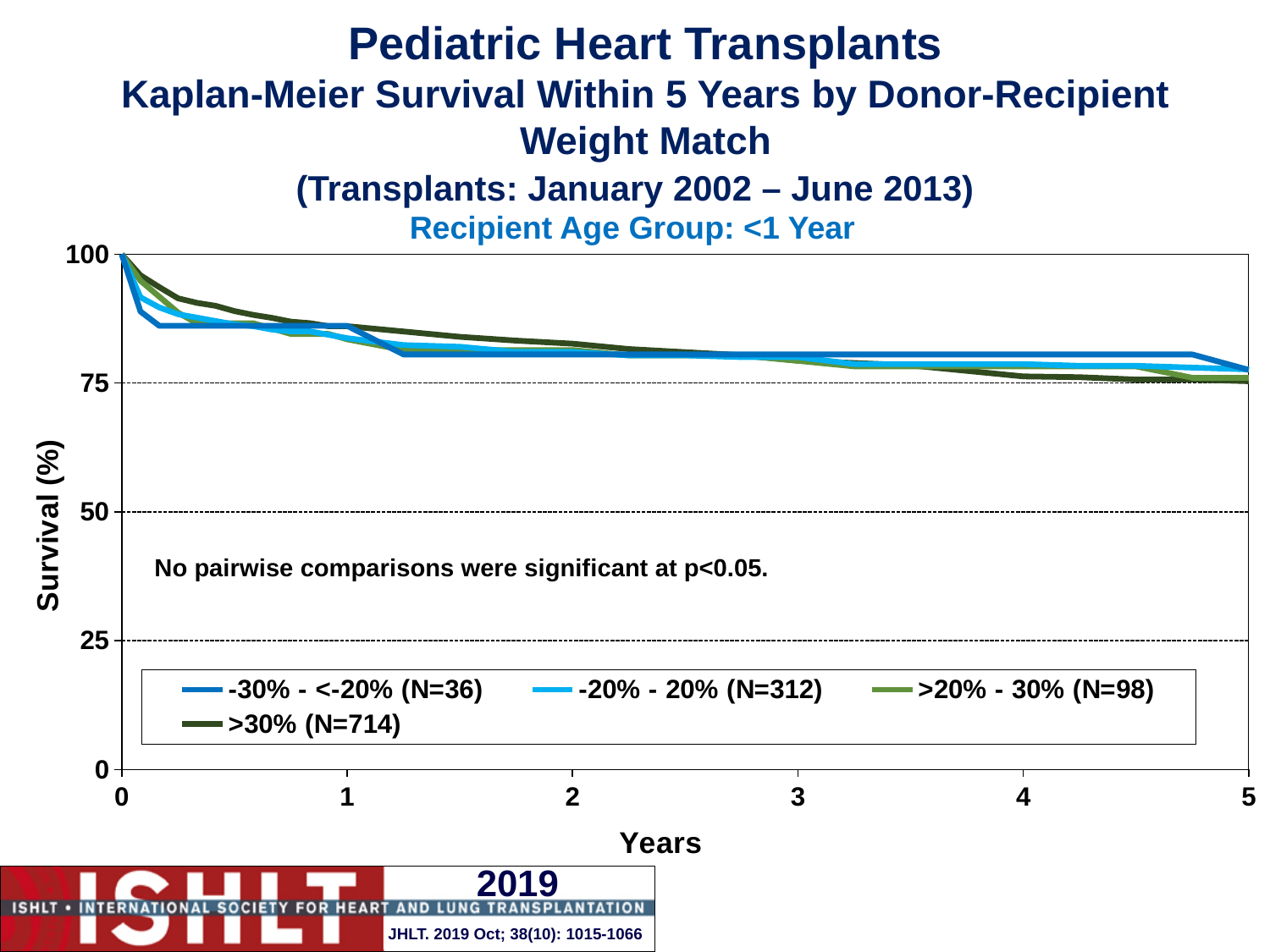
What is the survival value for all groups at year 0? 100 How many series does the legend list? 4 Is the survival for the -20% - 20% (N=312) group at year 1 greater or less than 75? greater What is the label of the y axis? Survival (%) Is the survival for the -30% - <-20% (N=36) group at year 2 greater or less than 100? less Is the survival for the >20% - 30% (N=98) group at year 4 greater or less than 50? greater What is the N for the >30% weight match group shown in the legend? 714 How many tick marks are labeled on the x axis (Years)? 6 What is the recipient age group stated in the chart title? <1 Year Do the survival curves rise or fall as years increase? fall What type of chart is shown on the slide? line chart